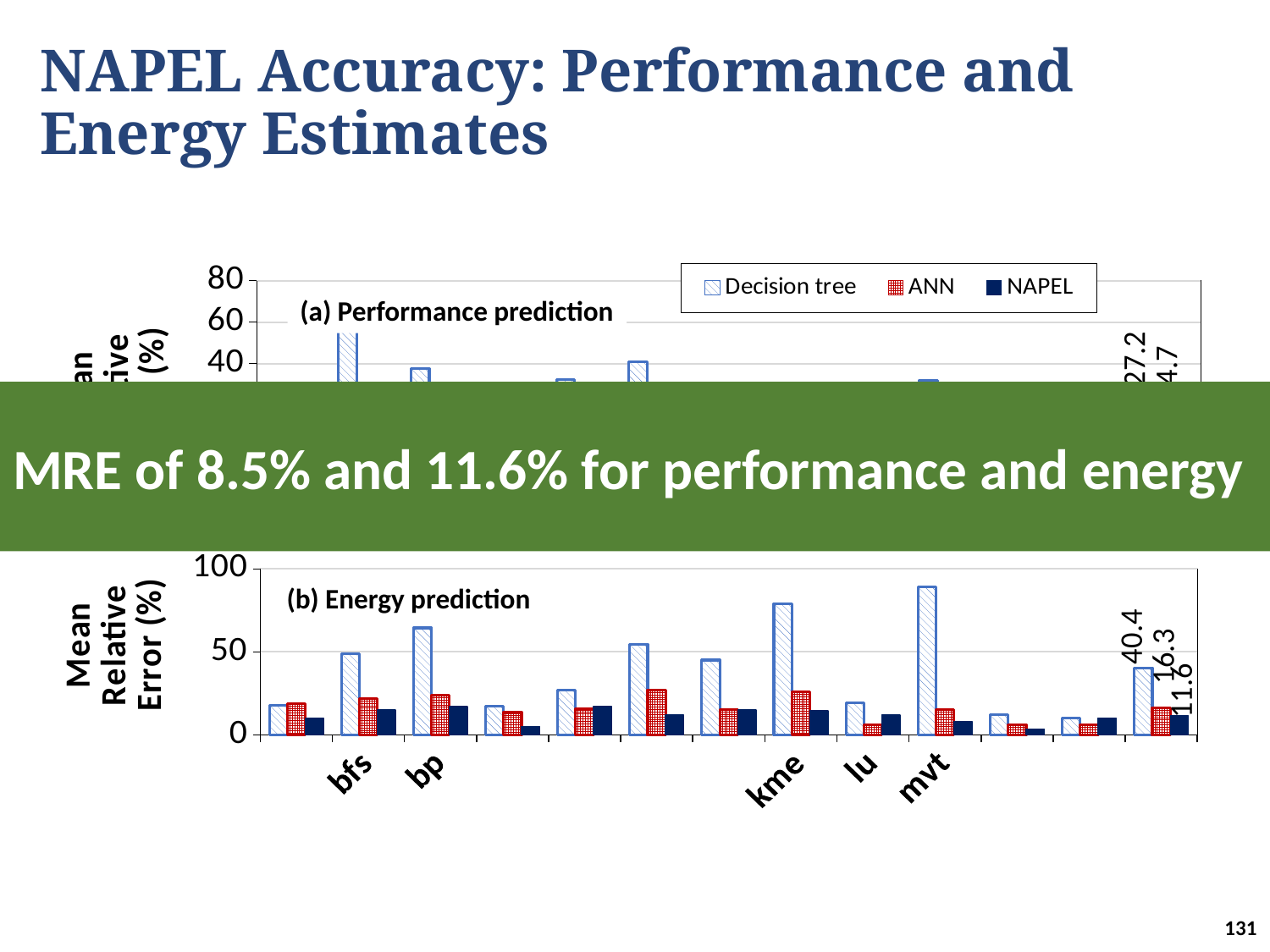
In chart (b) Energy prediction, which is larger for bp: the ANN value or the NAPEL value? ANN In chart (b) Energy prediction, what is the difference between the Decision tree value (40.4) and the NAPEL value (11.6) in the rightmost group of bars? 28.8 How many series does the legend list? 3 In chart (b) Energy prediction, what is the ANN value printed for the rightmost group of bars? 16.3 What are the three series named in the legend? Decision tree, ANN, NAPEL In chart (b) Energy prediction, is the Decision tree value for lu greater or less than 50? less In chart (b) Energy prediction, what is the Decision tree value printed for the rightmost group of bars? 40.4 In chart (b) Energy prediction, what is the NAPEL value printed for the rightmost group of bars? 11.6 What kind of chart is chart (b) Energy prediction? bar chart What is the y-axis label of chart (b) Energy prediction? Mean Relative Error (%) In chart (b) Energy prediction, which category has the highest Decision tree value? mvt In chart (b) Energy prediction, is the Decision tree value for bp greater or less than 50? greater